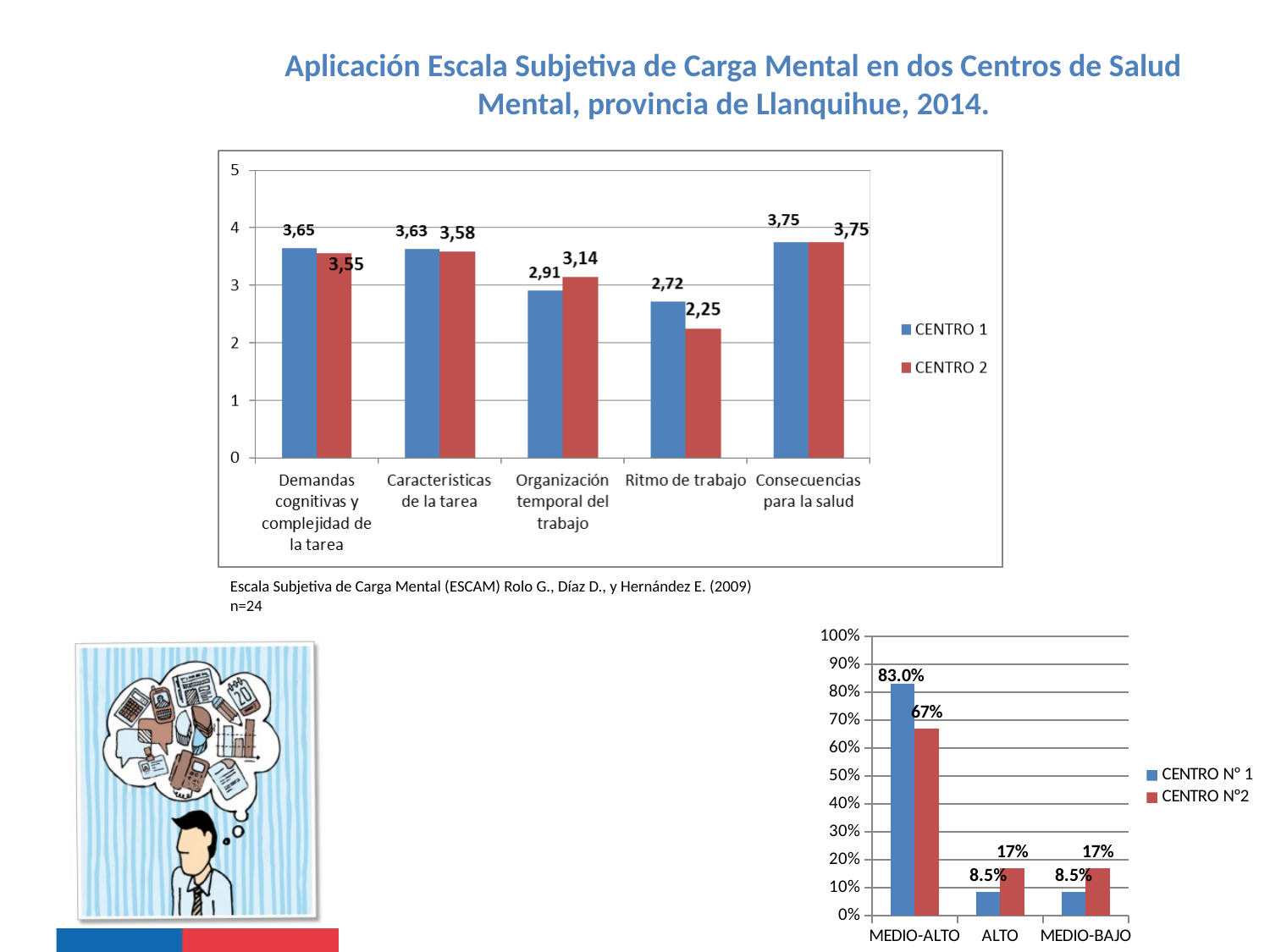
In the top chart, what is the difference between the CENTRO 1 and CENTRO 2 values for Ritmo de trabajo? 0,47 In the top chart, which is larger for Organización temporal del trabajo, CENTRO 1 or CENTRO 2? CENTRO 2 In the top chart, what is the CENTRO 1 value for Ritmo de trabajo? 2,72 How many categories are shown on the x axis of the top chart? 5 In the top chart, what is the CENTRO 2 value for Organización temporal del trabajo? 3,14 In the bottom-right chart, what is the CENTRO N° 1 value for MEDIO-ALTO? 83.0% In the top chart, which category has the highest CENTRO 1 value? Consecuencias para la salud In the bottom-right chart, what is the difference between the CENTRO N°2 and CENTRO N° 1 values for ALTO? 8.5% How many series does the legend of the top chart list? 2 In the top chart, which category has the lowest CENTRO 2 value? Ritmo de trabajo What kind of chart is the bottom-right chart? Bar chart In the bottom-right chart, which category has the highest CENTRO N°2 value? MEDIO-ALTO